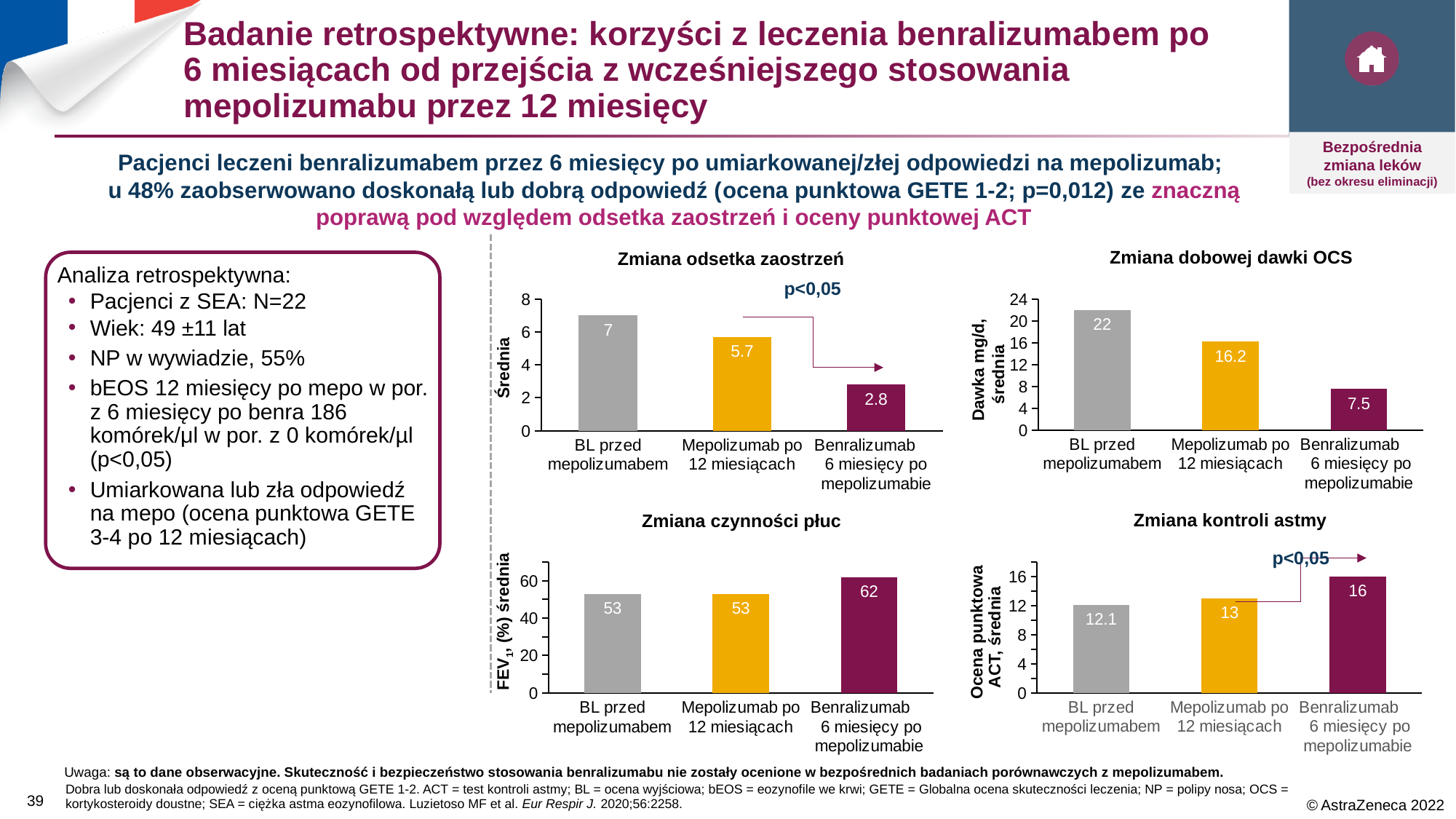
In the chart titled "Zmiana czynności płuc", is the value for "BL przed mepolizumabem" larger or smaller than the value for "Benralizumab 6 miesięcy po mepolizumabie"? smaller In the chart titled "Zmiana dobowej dawki OCS", which category has the lowest value? Benralizumab 6 miesięcy po mepolizumabie How many categories are shown in the chart titled "Zmiana kontroli astmy"? 3 What kind of chart is the chart titled "Zmiana czynności płuc"? bar chart In the chart titled "Zmiana odsetka zaostrzeń", what is the value for "Benralizumab 6 miesięcy po mepolizumabie"? 2.8 In the chart titled "Zmiana dobowej dawki OCS", what is the value for "Mepolizumab po 12 miesiącach"? 16.2 In the chart titled "Zmiana dobowej dawki OCS", what is the difference between the values for "BL przed mepolizumabem" and "Benralizumab 6 miesięcy po mepolizumabie"? 14.5 In the chart titled "Zmiana kontroli astmy", do the values rise or fall from left to right along the x axis? rise In the chart titled "Zmiana odsetka zaostrzeń", what is the difference between the values for "BL przed mepolizumabem" and "Mepolizumab po 12 miesiącach"? 1.3 In the chart titled "Zmiana kontroli astmy", what is the value for "BL przed mepolizumabem"? 12.1 In the chart titled "Zmiana odsetka zaostrzeń", which category has the highest value? BL przed mepolizumabem In the chart titled "Zmiana czynności płuc", what is the value for "Benralizumab 6 miesięcy po mepolizumabie"? 62